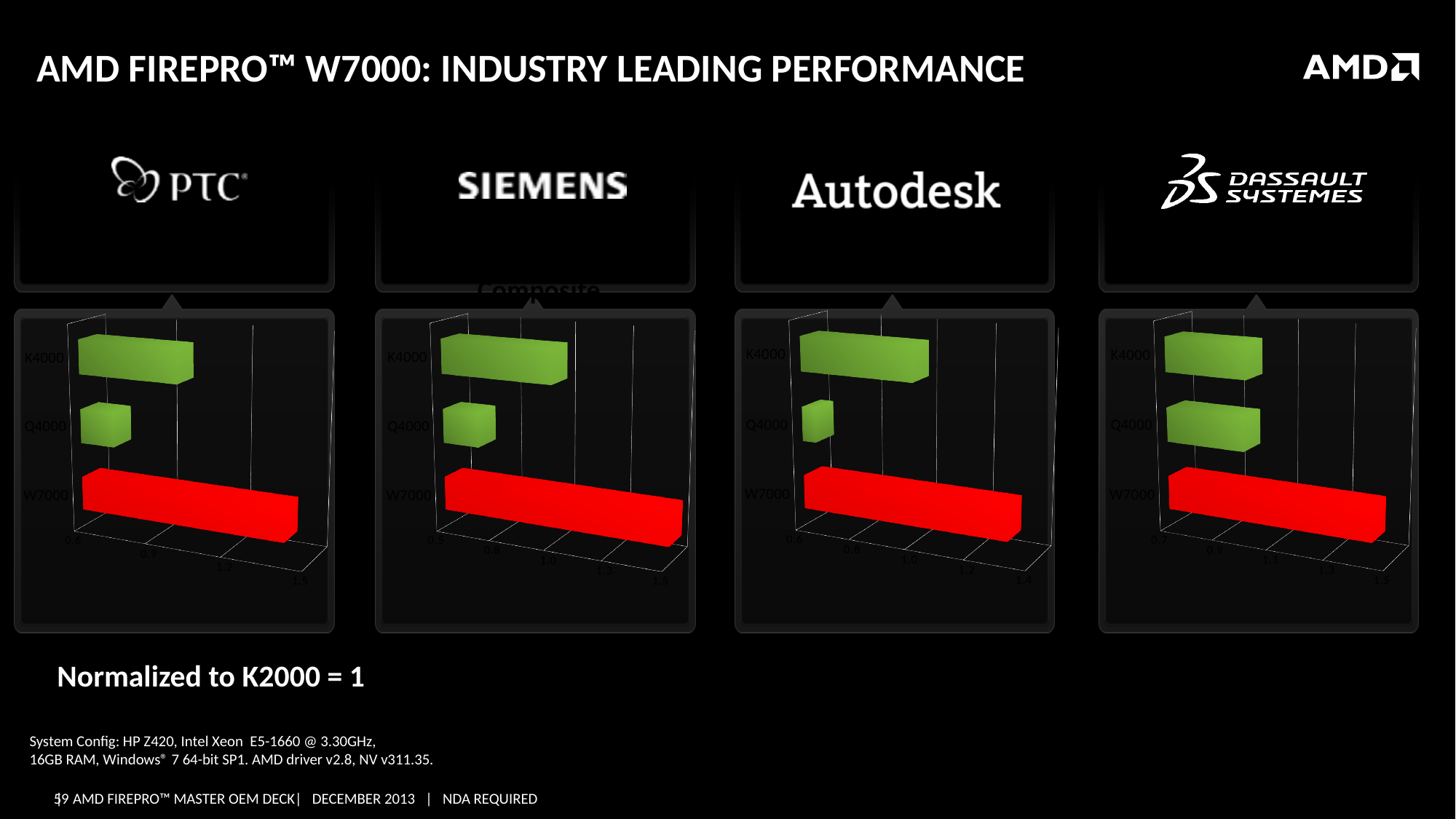
In the chart under the Autodesk logo, which is larger, the value for W7000 or the value for K4000? W7000 In the chart under the Siemens logo, which is larger, the value for K4000 or the value for Q4000? K4000 What colour is the W7000 bar in each of the four charts? red In the chart under the PTC logo, which category has the highest value? W7000 In the chart under the PTC logo, is the value for W7000 greater or less than 1.2? greater How many categories does the chart under the Siemens logo show? 3 In the chart under the Autodesk logo, which category has the lowest value? Q4000 What kind of chart is shown under the PTC logo? bar chart In the chart under the Dassault Systèmes logo, which category has the highest value? W7000 In the chart under the PTC logo, is the value for Q4000 greater or less than 0.9? less In the chart under the Autodesk logo, is the value for Q4000 greater or less than 0.8? less